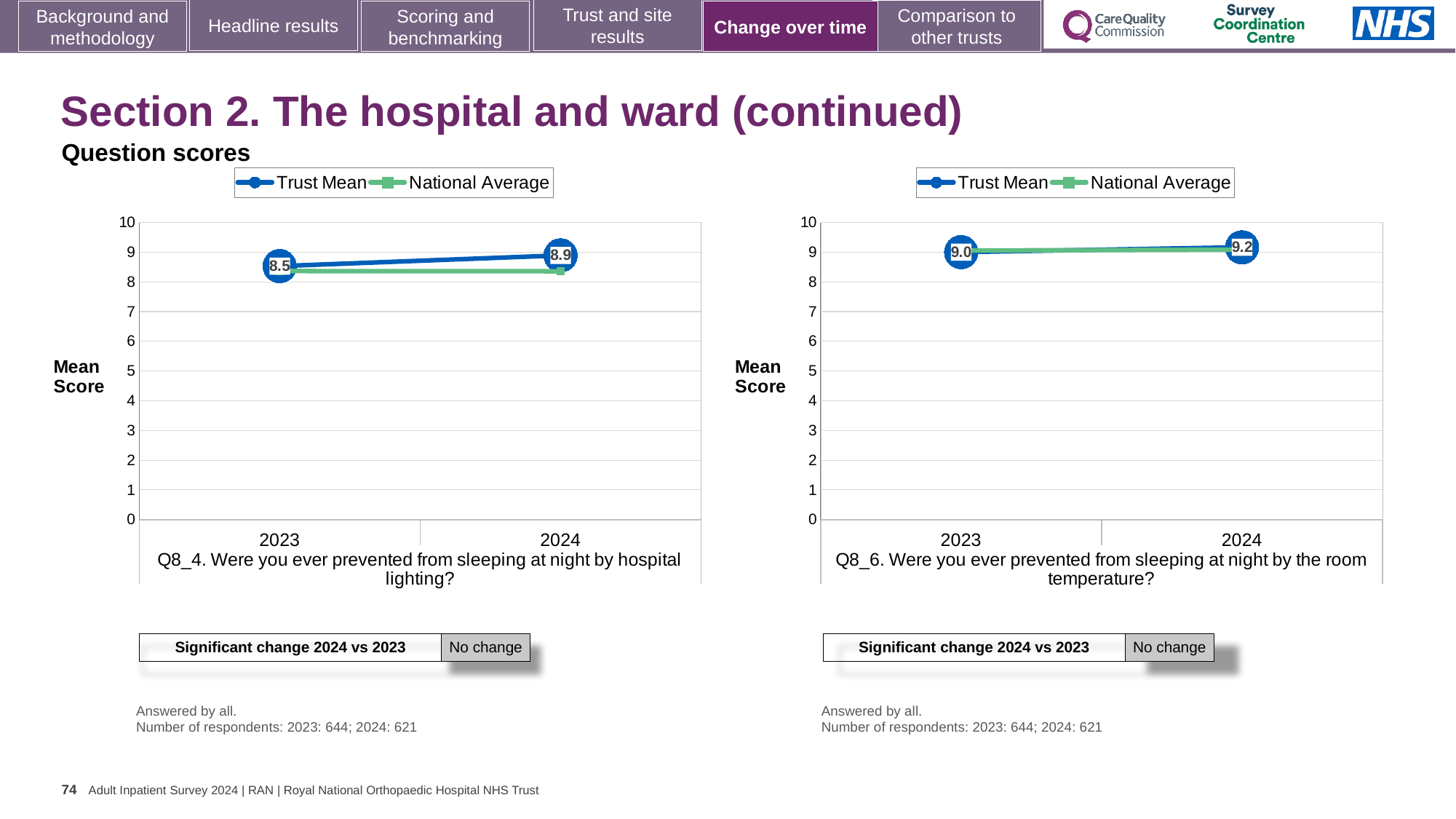
What type of chart is the left chart (Q8_4, hospital lighting)? line chart In the left chart (Q8_4, hospital lighting), what is the Trust Mean score for 2023? 8.5 In the left chart (Q8_4, hospital lighting), which is larger in 2024, the Trust Mean or the National Average? Trust Mean In the left chart (Q8_4, hospital lighting), is the National Average for 2024 greater or less than 8? greater In the right chart (Q8_6, room temperature), what is the difference between the Trust Mean in 2024 and in 2023? 0.2 How many series does the legend of the right chart (Q8_6, room temperature) list? 2 In the right chart (Q8_6, room temperature), what is the Trust Mean score for 2023? 9.0 In the left chart (Q8_4, hospital lighting), what is the Trust Mean score for 2024? 8.9 In the right chart (Q8_6, room temperature), what is the Trust Mean score for 2024? 9.2 In the left chart (Q8_4, hospital lighting), does the Trust Mean rise or fall from 2023 to 2024? rise In the right chart (Q8_6, room temperature), which year has the higher Trust Mean score? 2024 In the left chart (Q8_4, hospital lighting), by how much did the Trust Mean change from 2023 to 2024? 0.4